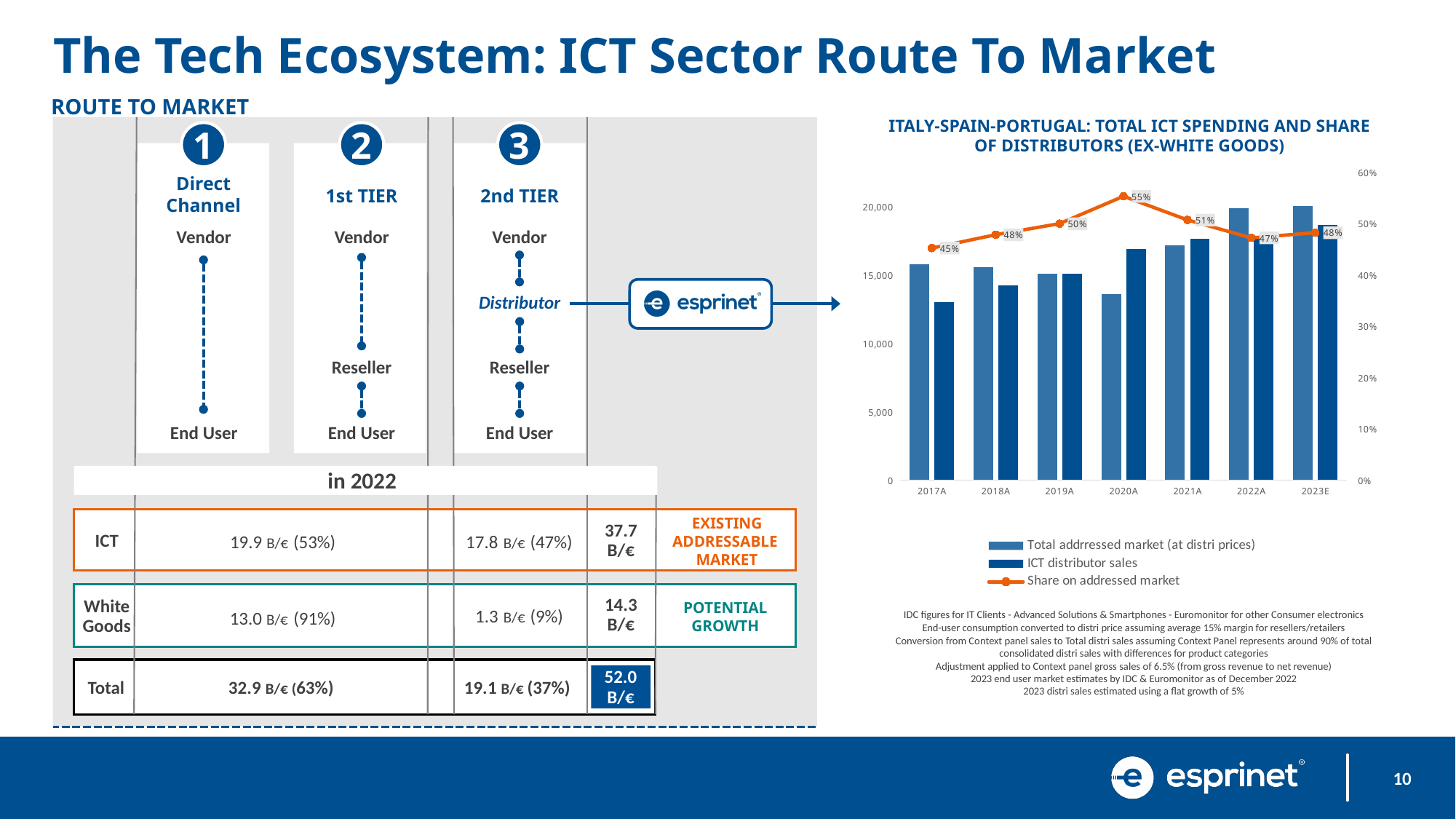
What is the share on addressed market for 2017A? 45% What is the share on addressed market for 2020A? 55% Is the value for ICT distributor sales in 2021A greater or less than 15,000? greater Which year has the larger share on addressed market, 2021A or 2022A? 2021A What is the share on addressed market for 2023E? 48% Is the value for Total addressed market (at distri prices) in 2020A greater or less than 15,000? less How many series does the chart legend list? 3 Does the share on addressed market rise or fall from 2017A to 2020A? rise In which year is the share on addressed market highest? 2020A How many years are shown on the x axis of the chart? 7 In which year is the share on addressed market lowest? 2017A By how many percentage points does the share on addressed market in 2020A exceed that in 2017A? 10 percentage points